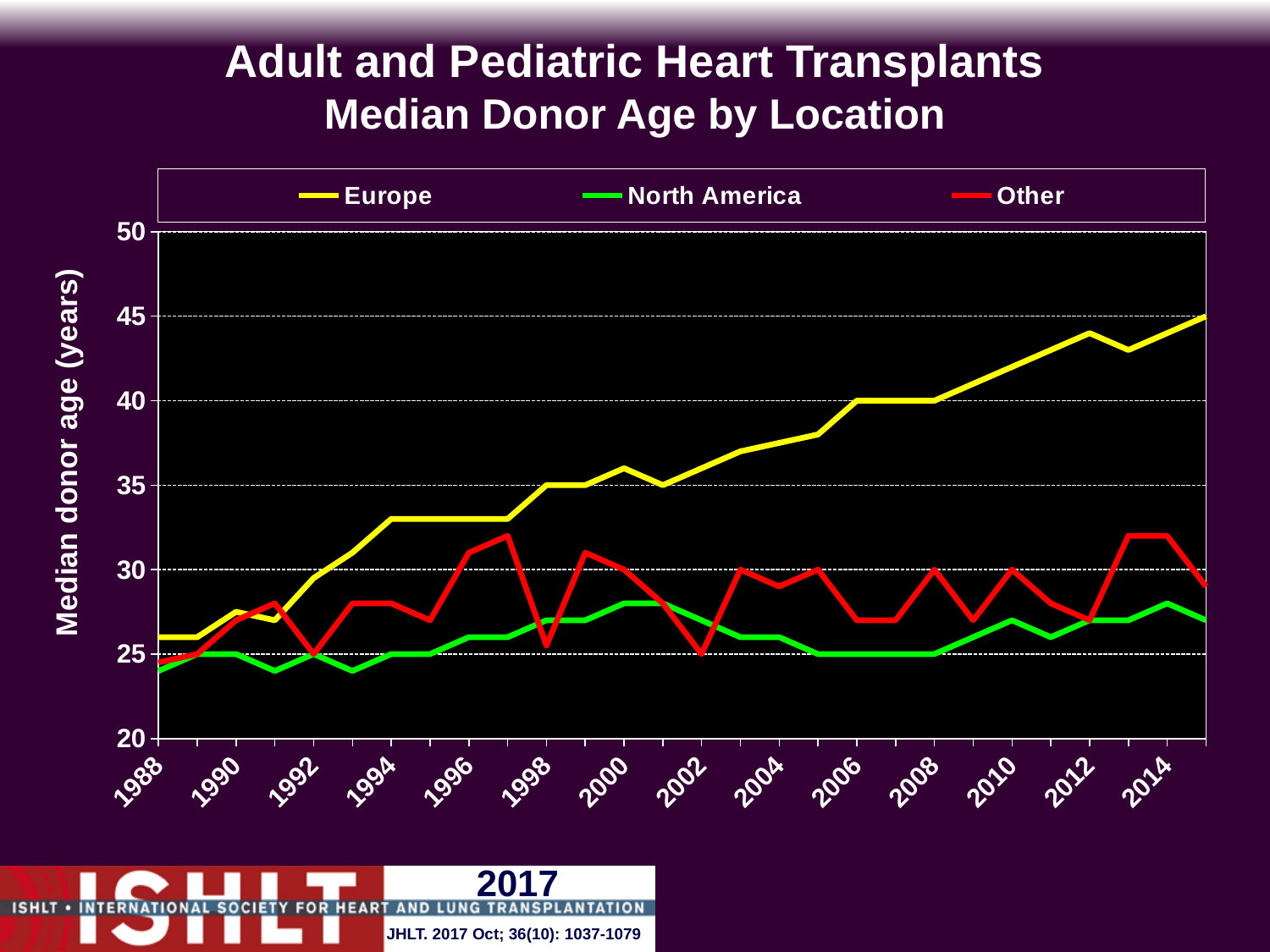
In 2010, which is larger, the value for Europe or the value for North America? Europe What kind of chart is shown on the slide? Line chart Does the Europe line generally rise or fall from 1988 to 2015? Rise Is the value for Europe in 1988 greater or less than 30? less Is the value for Other in 2013 greater or less than 30? greater What are the three series named in the legend? Europe, North America, Other What is the title of the chart? Adult and Pediatric Heart Transplants Median Donor Age by Location Is the value for Europe in 2014 greater or less than 40? greater How many series does the legend list? 3 Which series has the highest value in 2014? Europe How many year labels are shown on the x axis? 14